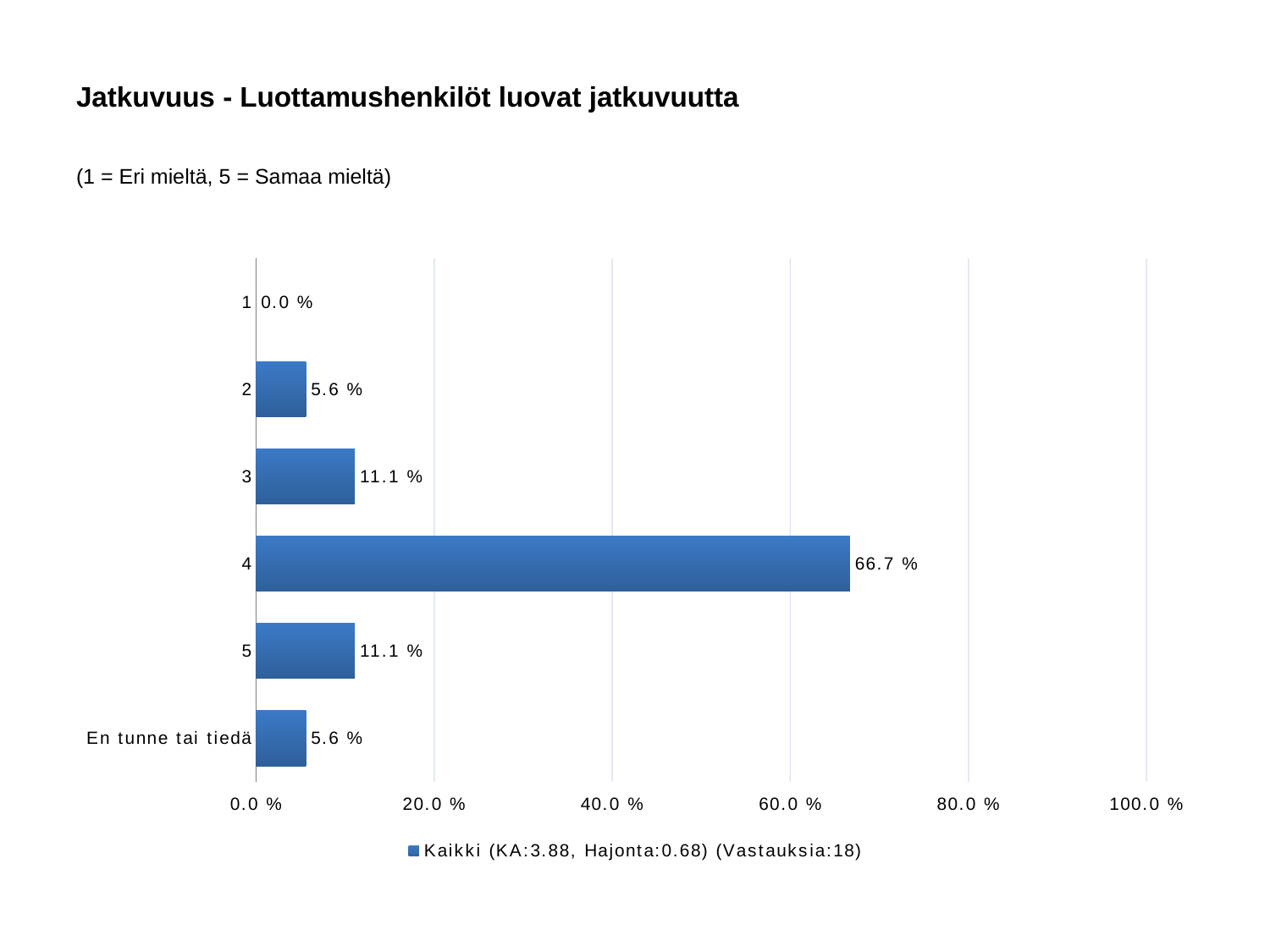
Which category has the highest value? 4 What is the value for category 1? 0.0 % What kind of chart is shown on the slide? bar chart What is the value for "En tunne tai tiedä"? 5.6 % How many categories are shown on the chart? 6 Which category has the lowest value? 1 What is the difference between the values for category 4 and category 3? 55.6 % What is the value for category 2? 5.6 % What is the value for category 4? 66.7 % How many responses (Vastauksia) does the legend entry report? 18 Is the value for category 4 greater or less than 60.0 %? greater Which is larger, the value for category 3 or the value for category 2? 3